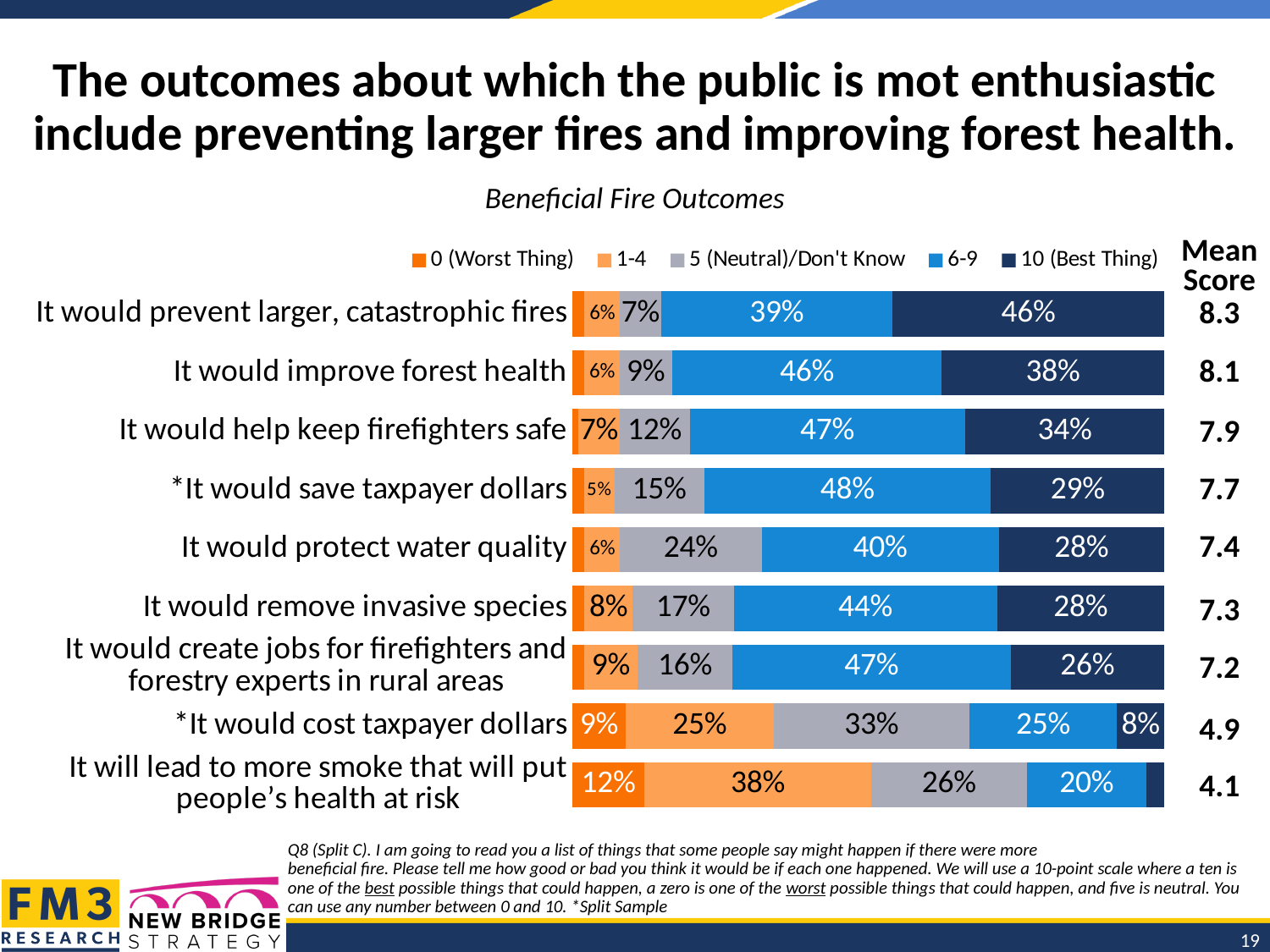
How many percentage points higher is the 10 (Best Thing) share for 'It would prevent larger, catastrophic fires' than for 'It would improve forest health'? 8 percentage points What type of chart is shown on the slide? Stacked bar chart What percentage chose 5 (Neutral)/Don't Know for '*It would cost taxpayer dollars'? 33% Which outcome has the highest Mean Score? It would prevent larger, catastrophic fires What is the Mean Score shown for 'It would improve forest health'? 8.1 How many outcomes are listed in the chart? 9 In the Beneficial Fire Outcomes chart, what percentage rated 'It would prevent larger, catastrophic fires' as 10 (Best Thing)? 46% Which has a larger 6-9 share: '*It would save taxpayer dollars' or 'It would protect water quality'? *It would save taxpayer dollars Which outcome has the lowest Mean Score? It will lead to more smoke that will put people's health at risk What is the title of the chart? Beneficial Fire Outcomes What percentage gave a 1-4 rating for 'It will lead to more smoke that will put people's health at risk'? 38% How many series does the legend list? 5